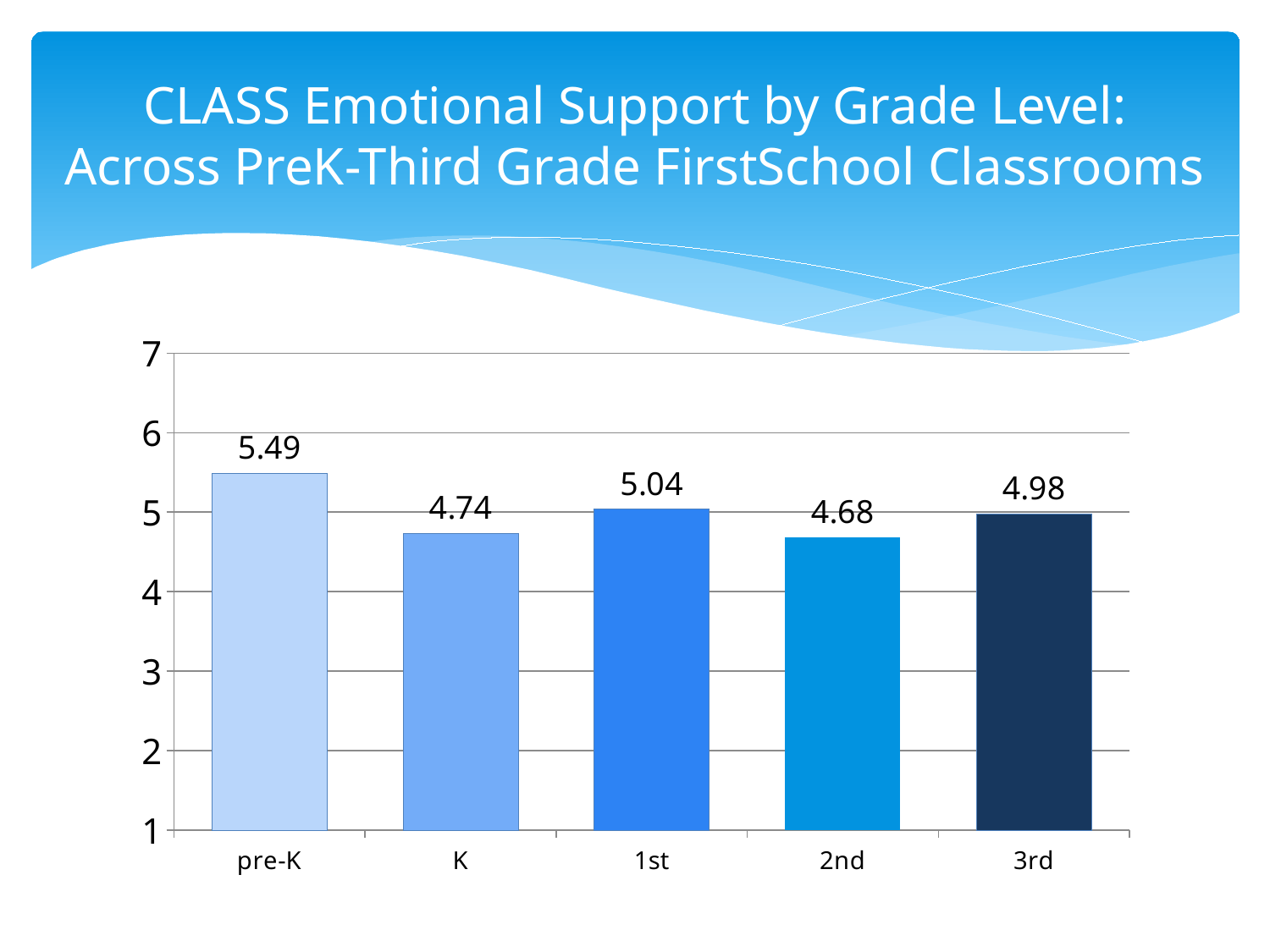
Is the value for K greater or less than 5? less What kind of chart is shown on the slide? bar chart What is the title of the slide? CLASS Emotional Support by Grade Level: Across PreK-Third Grade FirstSchool Classrooms What is the value shown for 3rd grade? 4.98 How many grade levels are shown on the chart? 5 What is the CLASS Emotional Support value for pre-K? 5.49 What is the value shown for 2nd grade? 4.68 Which grade level has the highest value? pre-K What is the difference between the 1st grade value and the 2nd grade value? 0.36 What is the difference between the pre-K value and the K value? 0.75 Which is larger, the value for 1st grade or the value for 3rd grade? 1st Which grade level has the lowest value? 2nd